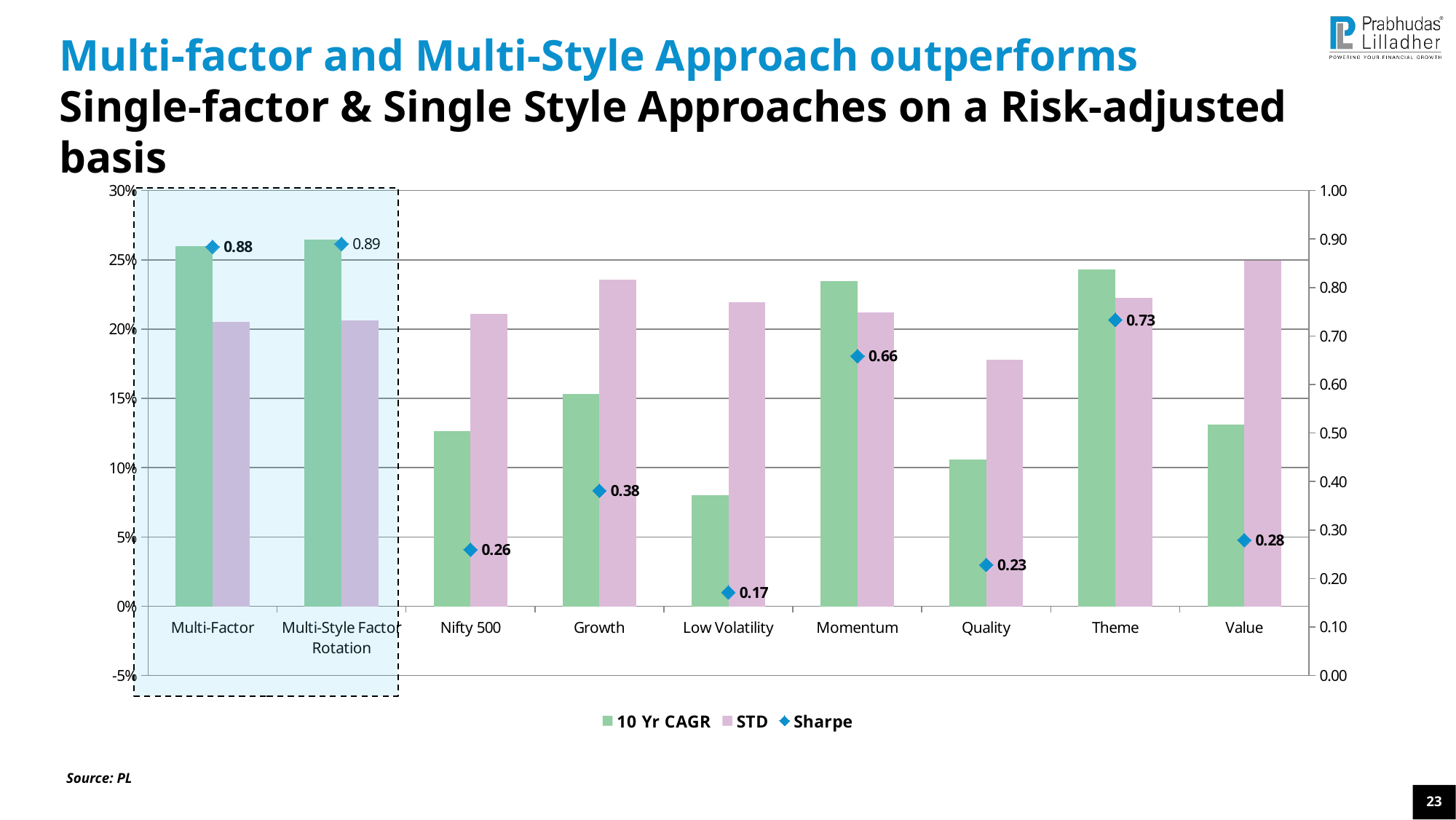
Is the 10 Yr CAGR bar for Multi-Factor greater or less than 25%? greater Which category has the highest Sharpe value? Multi-Style Factor Rotation What is the Sharpe value shown for Theme? 0.73 Is the 10 Yr CAGR bar for Low Volatility greater or less than 10%? less Which has a higher Sharpe value, Momentum or Theme? Theme What is the difference between the Sharpe values of Multi-Style Factor Rotation and Low Volatility? 0.72 Which series in the legend is plotted as blue diamond markers? Sharpe How many categories are shown on the x axis of the chart? 9 What is the Sharpe value shown for Multi-Factor? 0.88 What is the Sharpe value shown for Low Volatility? 0.17 How many series does the chart legend list? 3 Which category has the lowest Sharpe value? Low Volatility